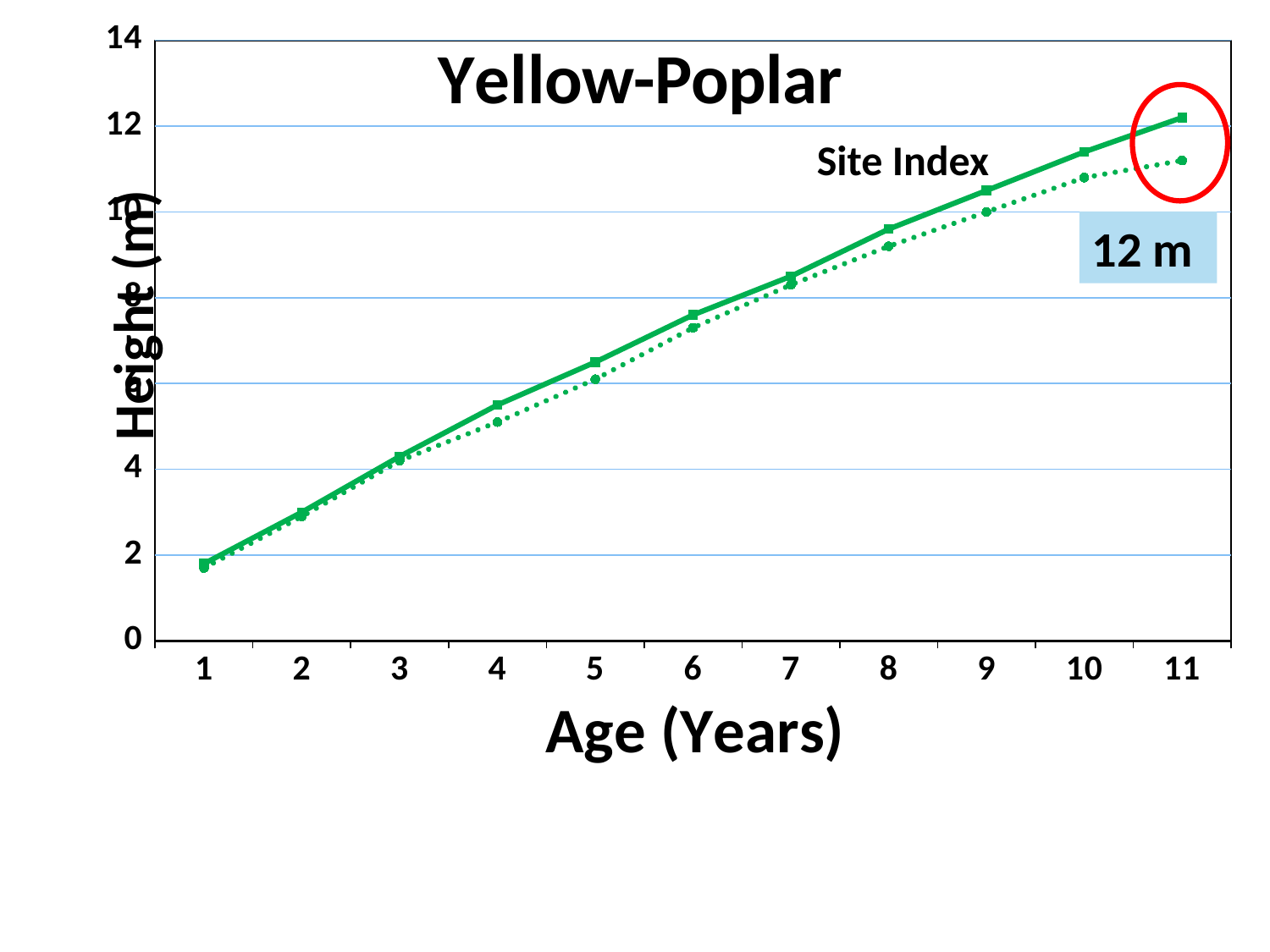
Is the value of the solid line at age 4 greater or less than 4? greater What is the title of the chart? Yellow-Poplar What is the label of the x axis? Age (Years) Do the plotted heights rise or fall as age increases? rise At which age is the height of the solid line highest? 11 At age 11, which line is higher, the solid line or the dotted line? solid line Is the value of the solid line at age 6 greater or less than 6? greater At which age is the height of the solid line lowest? 1 What kind of chart is shown on the slide? line chart Is the value of the dotted line at age 11 greater or less than 12? less How many age values are plotted along the x axis? 11